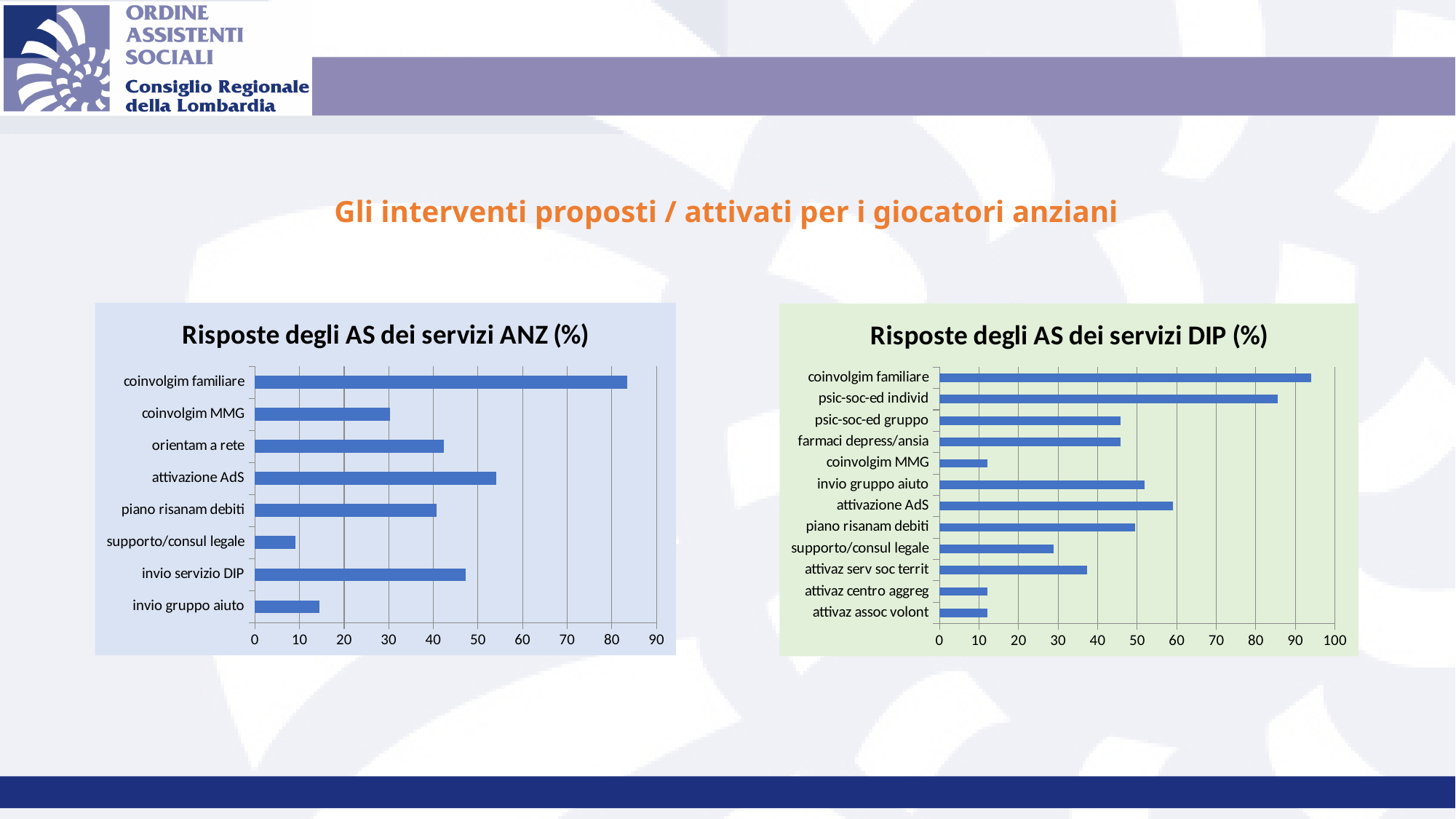
How many categories are shown in the 'Risposte degli AS dei servizi ANZ (%)' chart? 8 In the 'Risposte degli AS dei servizi DIP (%)' chart, which category has the highest value? coinvolgim familiare In the 'Risposte degli AS dei servizi DIP (%)' chart, is the value for psic-soc-ed individ greater or less than 80? greater In the 'Risposte degli AS dei servizi DIP (%)' chart, is the value for coinvolgim MMG greater or less than 20? less How many categories are shown in the 'Risposte degli AS dei servizi DIP (%)' chart? 12 What kind of chart is the 'Risposte degli AS dei servizi ANZ (%)' chart? bar chart In the 'Risposte degli AS dei servizi ANZ (%)' chart, which category has the highest value? coinvolgim familiare In the 'Risposte degli AS dei servizi ANZ (%)' chart, is the value for invio gruppo aiuto greater or less than 20? less In the 'Risposte degli AS dei servizi ANZ (%)' chart, which is larger: attivazione AdS or coinvolgim MMG? attivazione AdS In the 'Risposte degli AS dei servizi ANZ (%)' chart, which category has the lowest value? supporto/consul legale In the 'Risposte degli AS dei servizi DIP (%)' chart, which is larger: attivazione AdS or supporto/consul legale? attivazione AdS